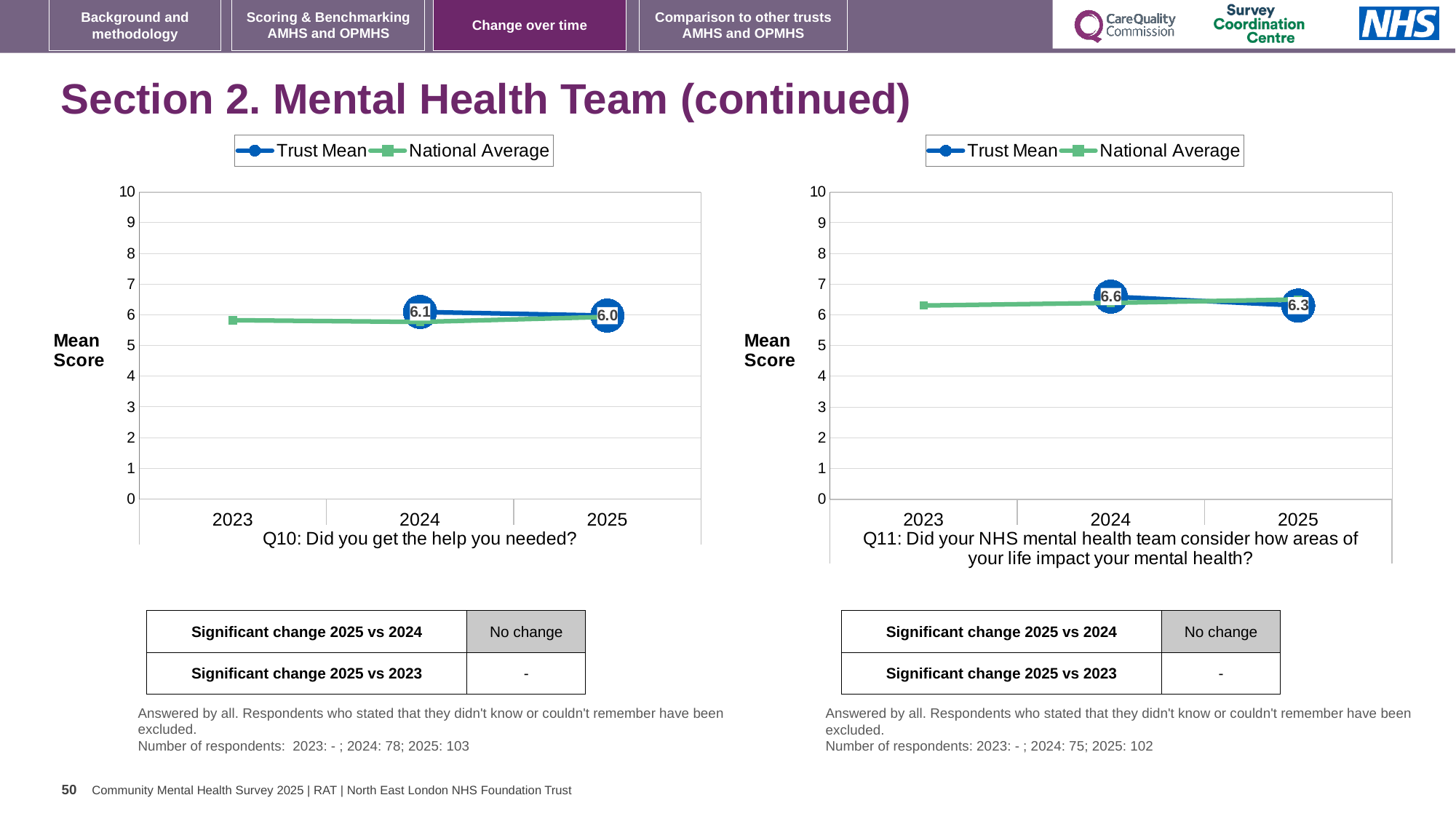
In the Q11 chart (right), what is the Trust Mean score for 2025? 6.3 In the Q11 chart (right), which year has the higher Trust Mean, 2024 or 2025? 2024 In the Q10 chart (left), does the Trust Mean rise or fall from 2024 to 2025? fall How many years are shown on the x axis of the Q11 chart (right)? 3 In the Q11 chart (right), what is the Trust Mean score for 2024? 6.6 In the Q10 chart (left), what is the Trust Mean score for 2025? 6.0 What kind of chart is the Q10 chart (left)? line chart In the Q10 chart (left), what is the Trust Mean score for 2024? 6.1 In the Q10 chart (left), is the National Average for 2023 greater or less than 7? less In the Q11 chart (right), is the National Average for 2023 greater or less than 5? greater How many series does the legend of the Q10 chart (left) list? 2 In the Q11 chart (right), by how much did the Trust Mean change from 2024 to 2025? 0.3